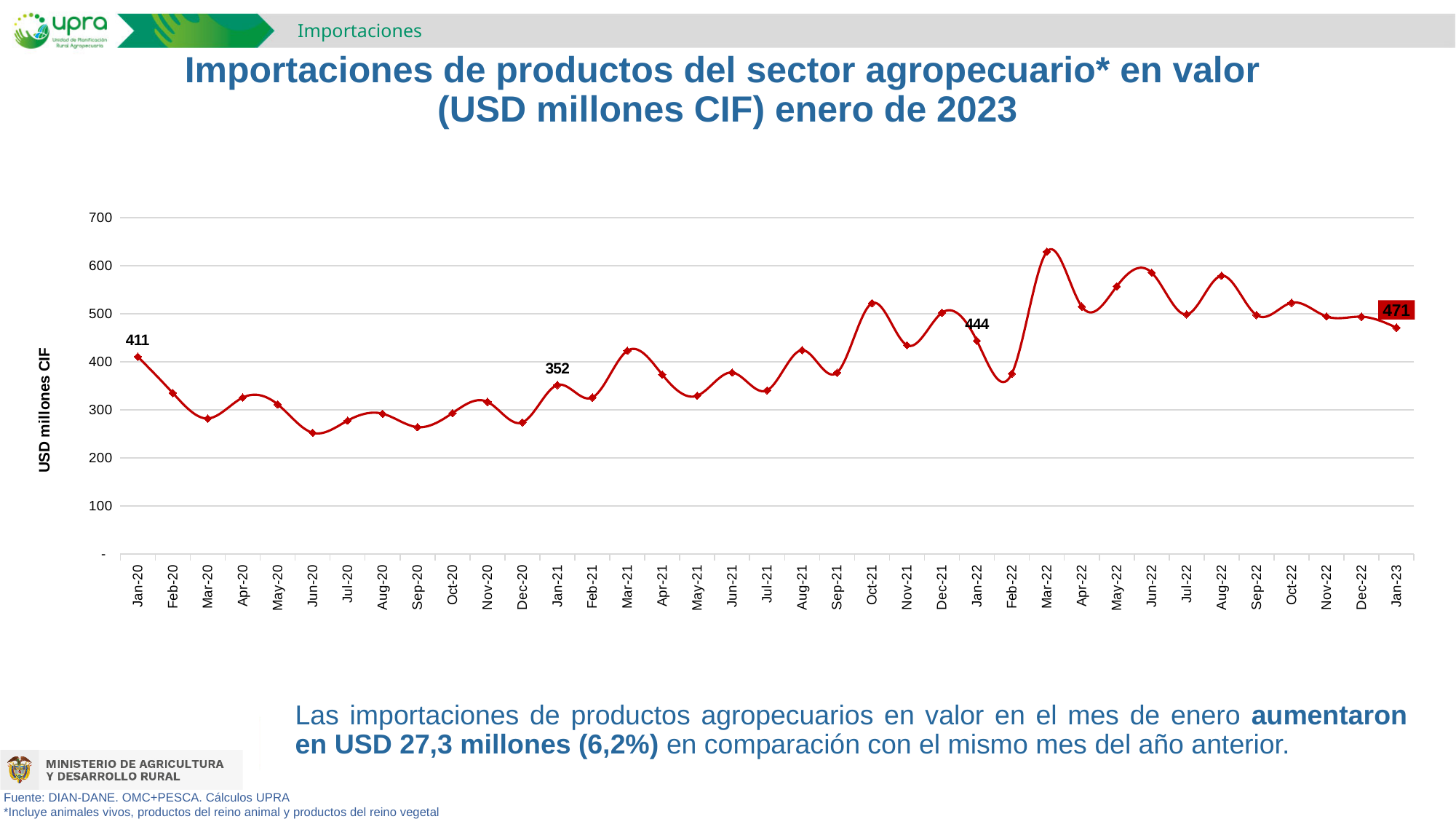
Is the value for Mar-22 greater or less than 600? greater What is the value for Jan-20? 411 What is the difference between the values for Jan-22 and Jan-21? 92 What is the value for Jan-22? 444 What is the label of the vertical axis? USD millones CIF Which month has the highest value on the chart? Mar-22 What is the value for Jan-23? 471 What is the value for Jan-21? 352 Which is larger, the value for Jan-23 or the value for Jan-20? Jan-23 What type of chart is shown on the slide? Line chart What is the difference between the values for Jan-23 and Jan-22? 27 Is the value for Jun-20 greater or less than 300? less